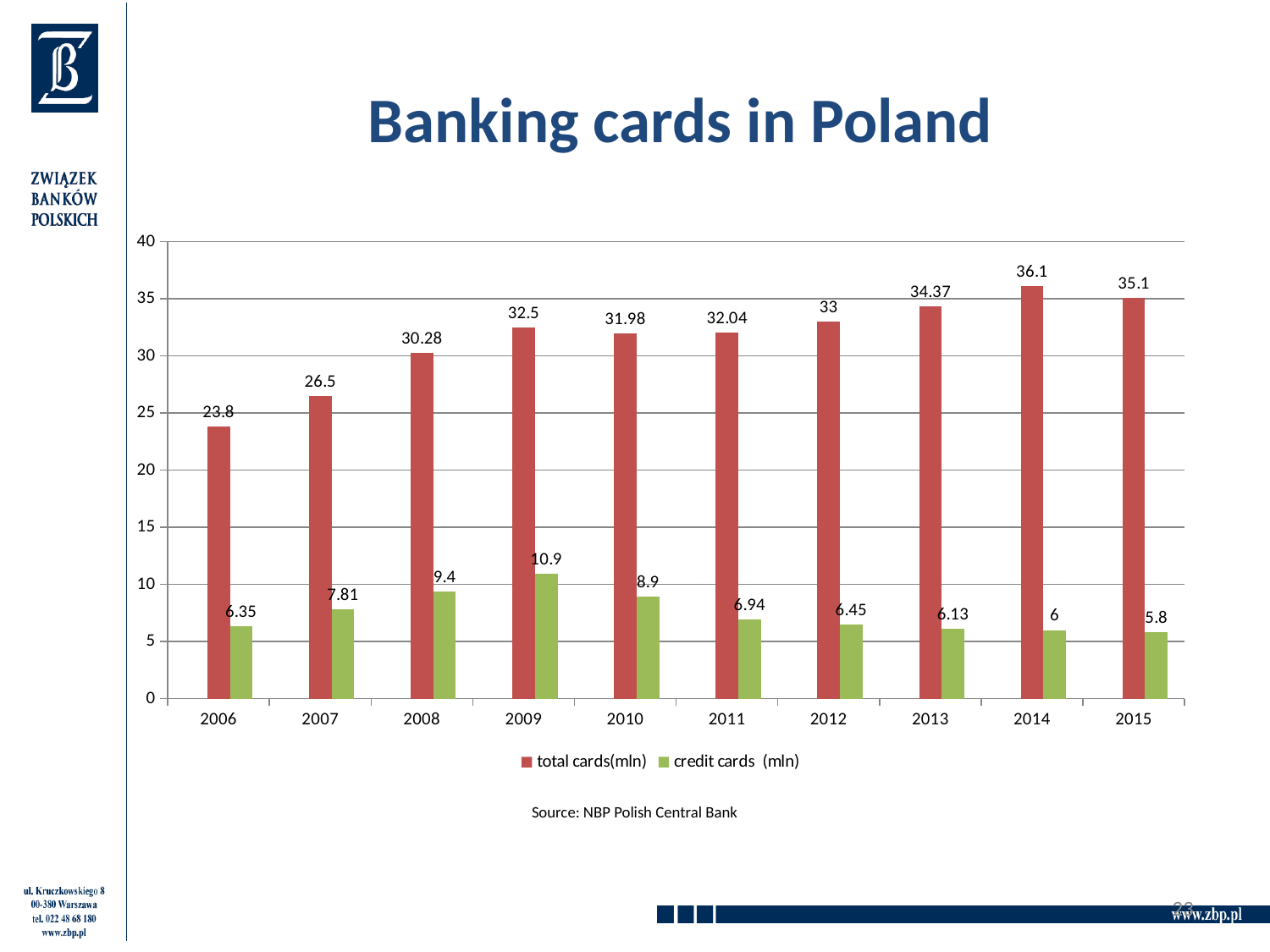
Is the value for total cards (mln) in 2007 greater or less than 25? greater What is the source cited below the chart? NBP Polish Central Bank What is the difference between total cards (mln) in 2014 and in 2006? 12.3 What is the value of total cards (mln) in 2008? 30.28 Which is larger: credit cards (mln) in 2008 or in 2010? 2008 In which year is the credit cards (mln) value highest? 2009 In which year is the total cards (mln) value highest? 2014 How many series does the legend list? 2 In which year is the credit cards (mln) value lowest? 2015 What kind of chart is shown on the slide? bar chart How many years are shown on the x axis? 10 What is the value of credit cards (mln) in 2011? 6.94